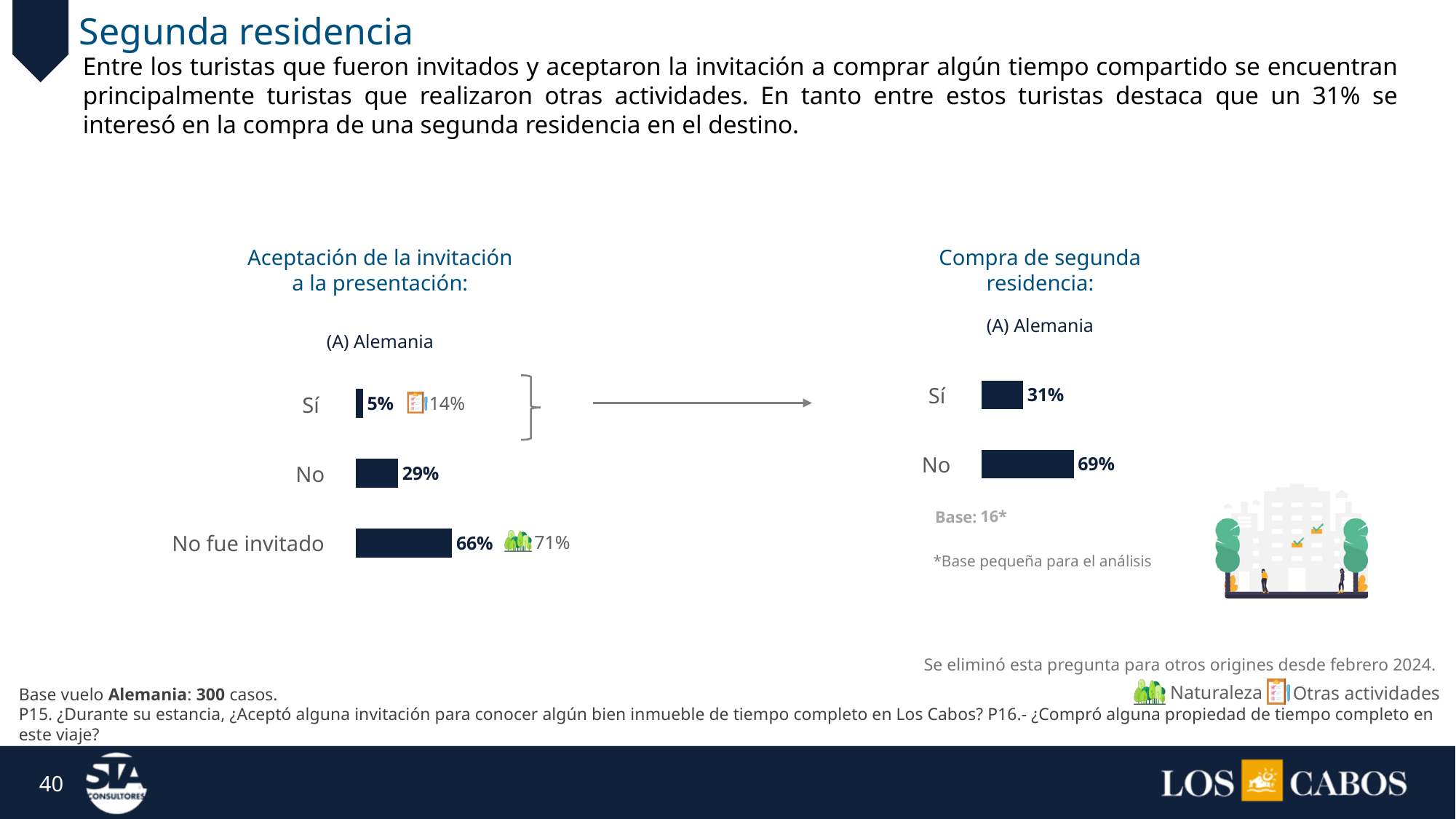
What kind of chart is the 'Compra de segunda residencia' chart? Bar chart How many categories does the 'Aceptación de la invitación a la presentación' chart show? 3 In the 'Aceptación de la invitación a la presentación' chart, what is the difference between 'No fue invitado' and 'No'? 37% In the 'Compra de segunda residencia' chart, what is the value for 'Sí'? 31% In the 'Compra de segunda residencia' chart, what is the value for 'No'? 69% In the 'Aceptación de la invitación a la presentación' chart, what is the value for 'No'? 29% In the 'Aceptación de la invitación a la presentación' chart, which category has the highest value? No fue invitado In the 'Aceptación de la invitación a la presentación' chart, what is the value for 'No fue invitado'? 66% In the 'Aceptación de la invitación a la presentación' chart, what is the value for 'Sí'? 5% In the 'Compra de segunda residencia' chart, what is the difference between 'No' and 'Sí'? 38% In the 'Aceptación de la invitación a la presentación' chart, which category has the lowest value? Sí In the 'Compra de segunda residencia' chart, which is larger, 'Sí' or 'No'? No